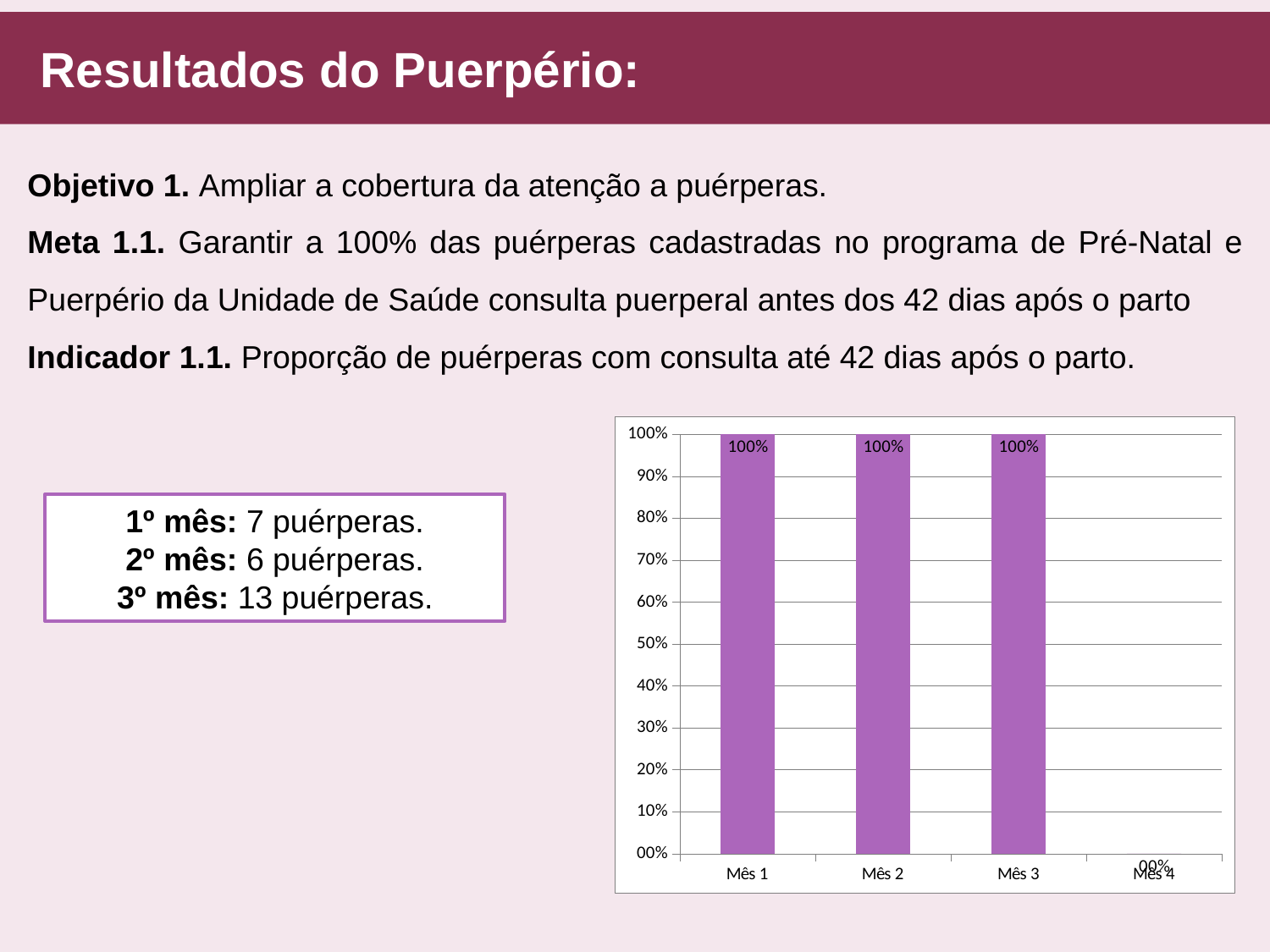
What is the value for Mês 4? 00% What is the difference between the value for Mês 1 and the value for Mês 4? 100% How many categories are shown on the x axis of the chart? 4 Which is larger, the value for Mês 3 or the value for Mês 4? Mês 3 What colour are the bars in the chart? purple What is the value for Mês 3? 100% What is the highest tick value shown on the y axis of the chart? 100% What kind of chart is shown on the slide? bar chart Is the value for Mês 2 greater or less than 50%? greater What is the value for Mês 2? 100% What is the value for Mês 1? 100% Which category has the lowest value? Mês 4